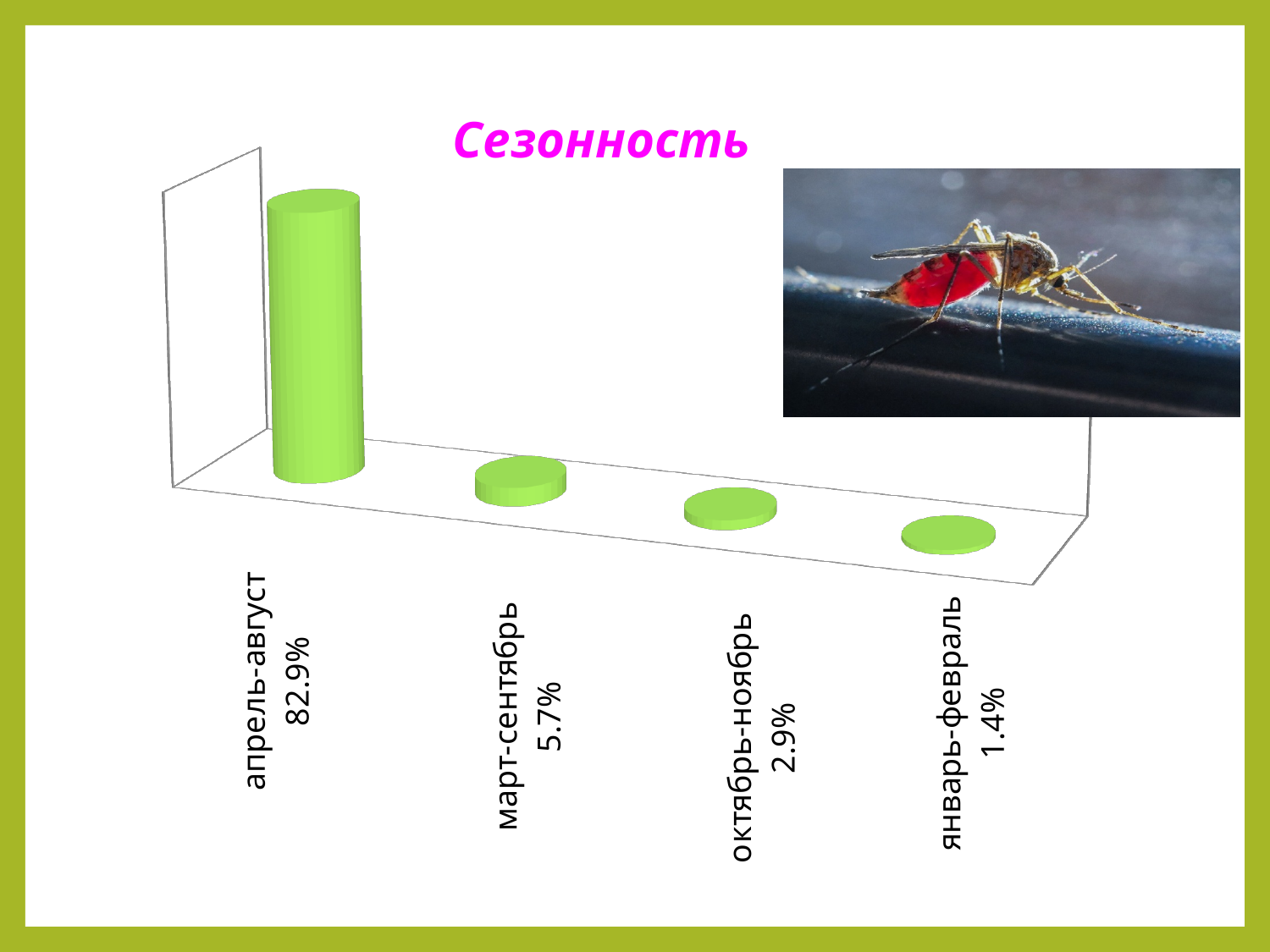
Which category has the highest value? апрель-август How many categories are shown in the chart? 4 What is the difference between the values for октябрь-ноябрь and январь-февраль? 1.5% What kind of chart is shown on the slide? bar chart Which category has the lowest value? январь-февраль What is the value for январь-февраль? 1.4% What is the difference between the values for апрель-август and март-сентябрь? 77.2% What is the title of the chart? Сезонность What is the value for октябрь-ноябрь? 2.9% Which is larger, the value for март-сентябрь or the value for октябрь-ноябрь? март-сентябрь What is the value for март-сентябрь? 5.7% What is the value for апрель-август? 82.9%